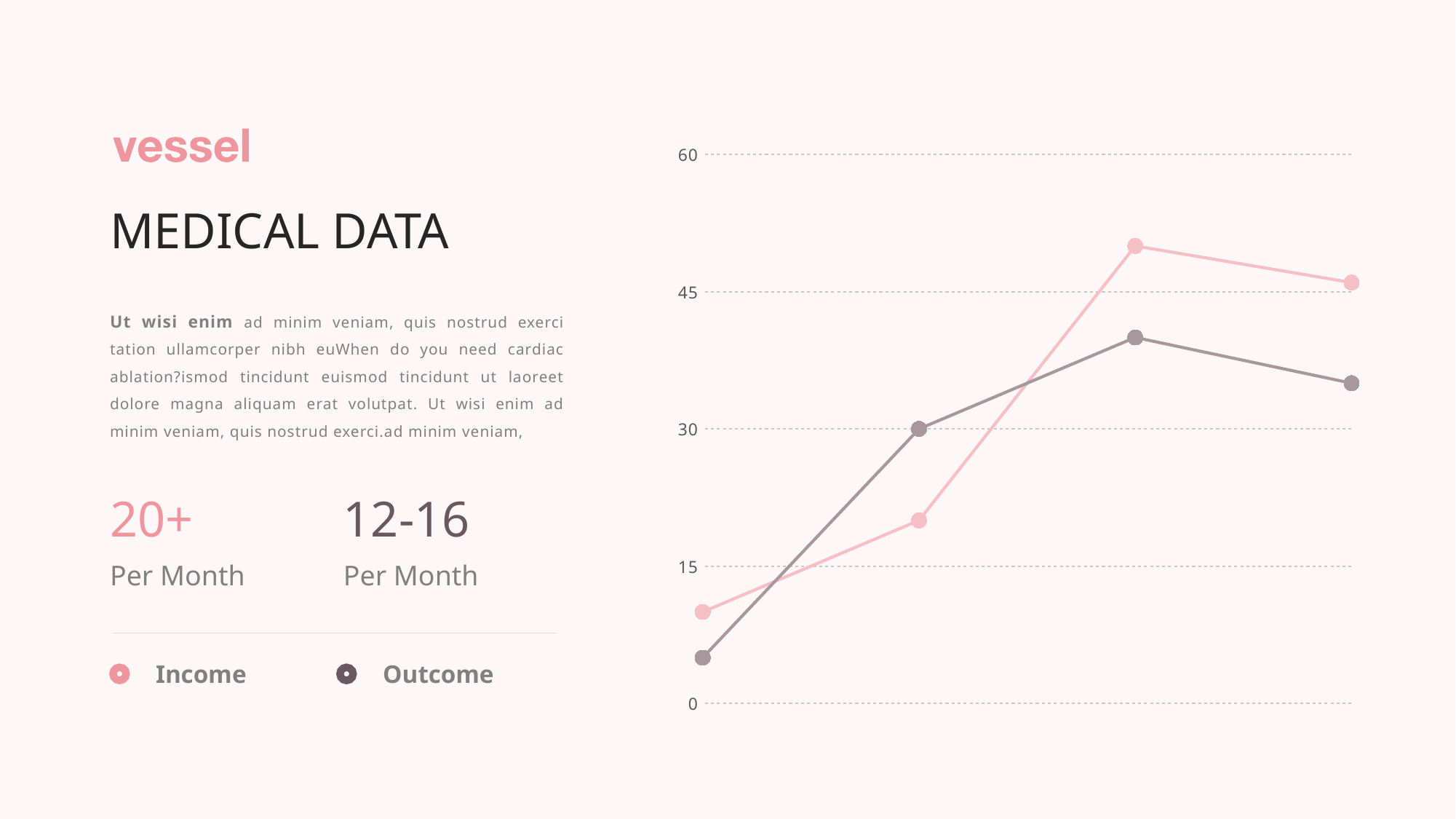
Is the value of the first point on the Income line greater or less than 15? less Is the value of the last point on the Outcome line greater or less than 30? greater What kind of chart is shown on the slide? line chart How many series does the legend list? 2 Is the value of the third point on the Outcome line greater or less than 45? less At the second point, which series has the larger value, Income or Outcome? Outcome At the third point, which series has the larger value, Income or Outcome? Income What are the two series named in the legend? Income and Outcome How many data points does each line have? 4 What is the value of the second point on the Outcome line? 30 Which point on the Income line has the highest value: the first, second, third or fourth? third